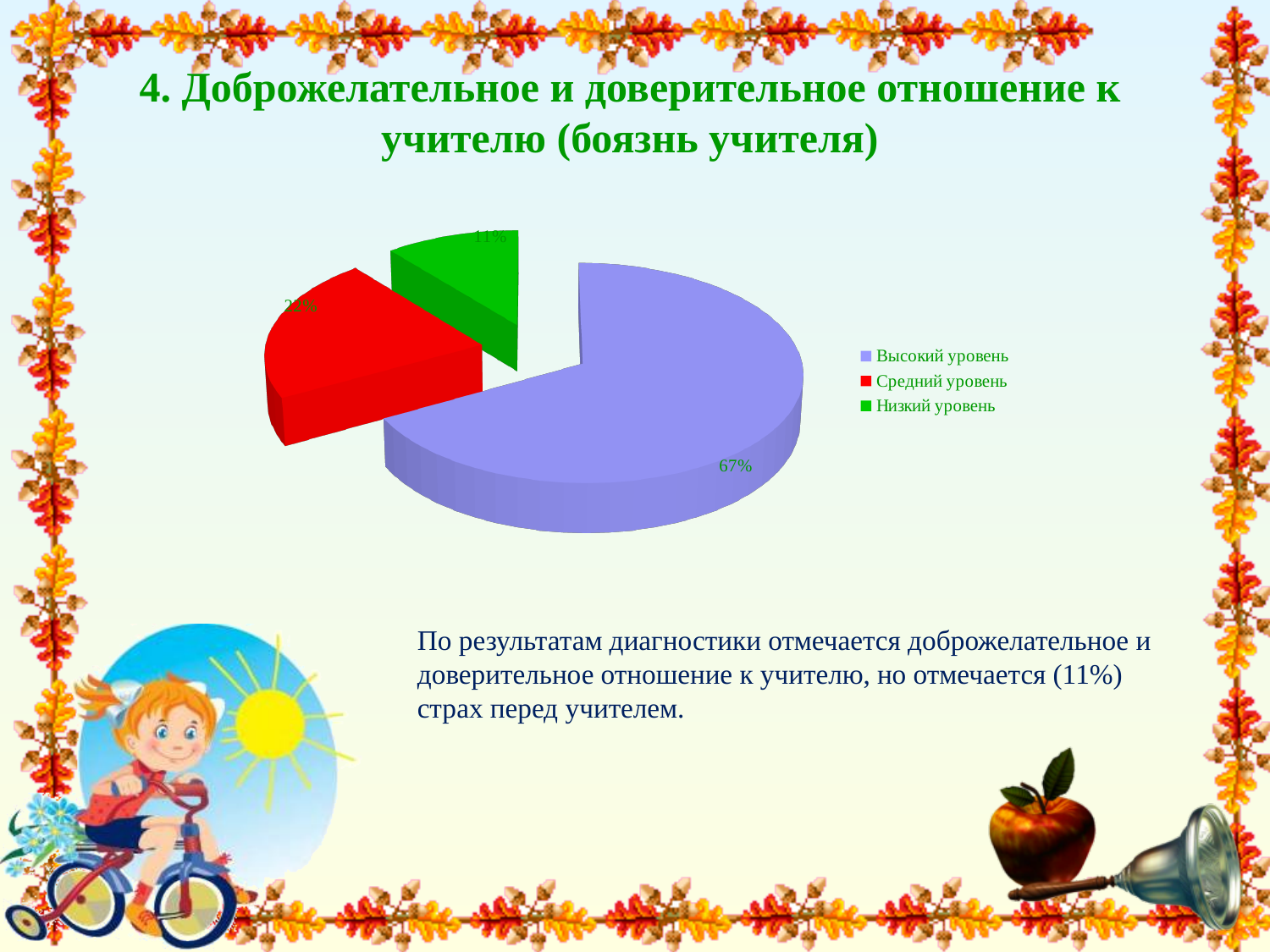
Which category has the smallest slice of the pie? Низкий уровень What colour is the slice for "Низкий уровень"? green Which category has the largest slice of the pie? Высокий уровень What is the difference between the shares of "Средний уровень" and "Низкий уровень"? 11% Which is larger: the share of "Средний уровень" or the share of "Низкий уровень"? Средний уровень What share of the pie does "Высокий уровень" have? 67% How many slices does the pie chart have? 3 What share of the pie does "Средний уровень" have? 22% What share of the pie does "Низкий уровень" have? 11% What is the difference between the shares of "Высокий уровень" and "Средний уровень"? 45% What kind of chart is shown on the slide? pie chart How many entries does the legend list? 3